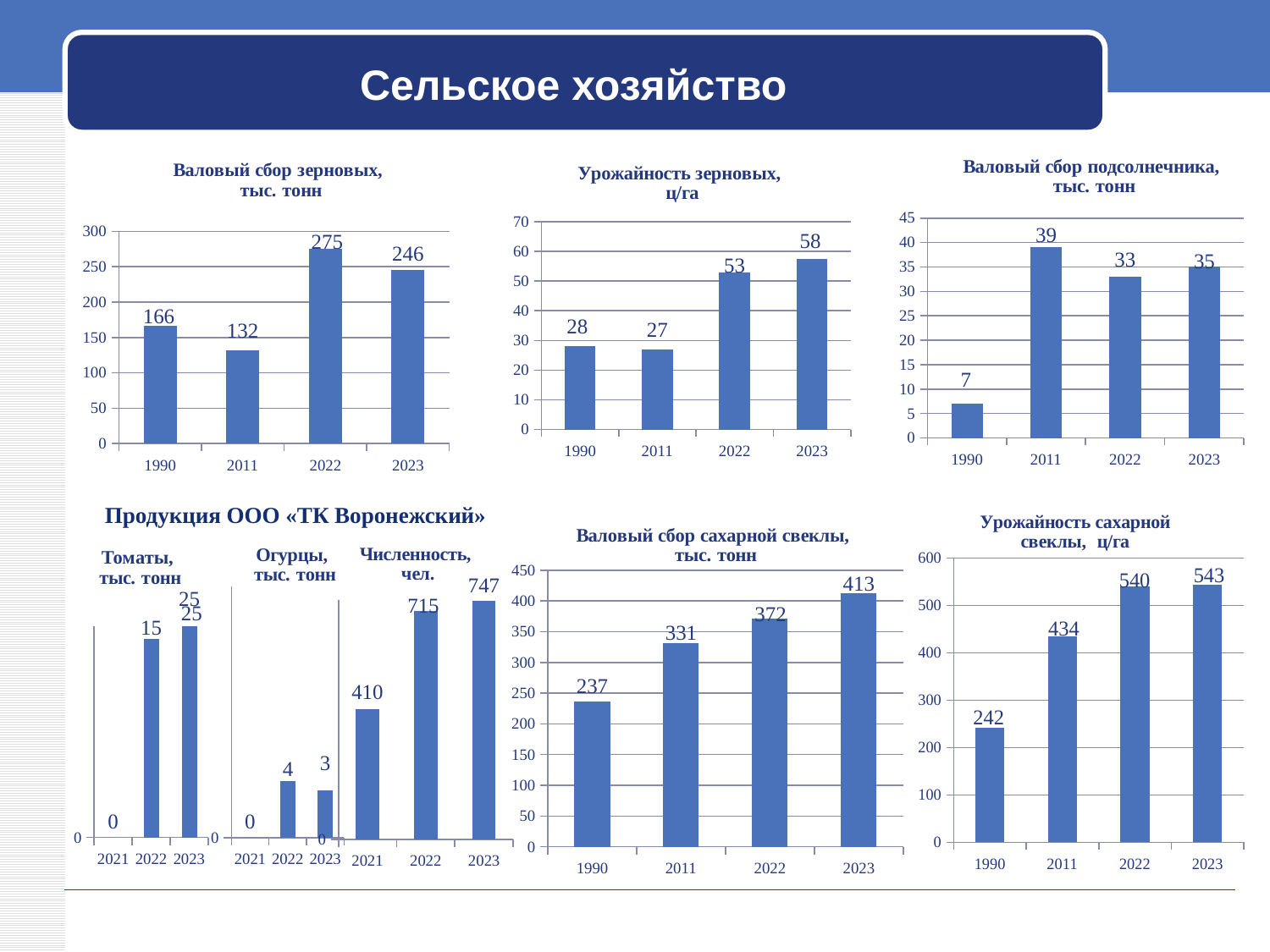
In the chart 'Урожайность зерновых, ц/га', what is the difference between the values for 2023 and 1990? 30 In the chart 'Валовый сбор сахарной свеклы, тыс. тонн', what is the value for 2011? 331 In the chart 'Валовый сбор сахарной свеклы, тыс. тонн', do the values rise or fall from 1990 to 2023? rise In the chart 'Урожайность сахарной свеклы, ц/га', which is larger, the value for 2011 or the value for 2022? 2022 In the chart 'Урожайность сахарной свеклы, ц/га', what is the difference between the values for 2022 and 1990? 298 In the chart 'Валовый сбор подсолнечника, тыс. тонн', which year has the highest value? 2011 In the 'Численность, чел.' chart under 'Продукция ООО «ТК Воронежский»', what is the value for 2021? 410 What type of chart is 'Валовый сбор зерновых, тыс. тонн'? bar chart In the chart 'Валовый сбор подсолнечника, тыс. тонн', what is the value for 1990? 7 In the chart 'Валовый сбор зерновых, тыс. тонн', which year has the lowest value? 2011 In the chart 'Урожайность зерновых, ц/га', what is the value for 2023? 58 In the chart 'Валовый сбор зерновых, тыс. тонн', what is the value for 2022? 275